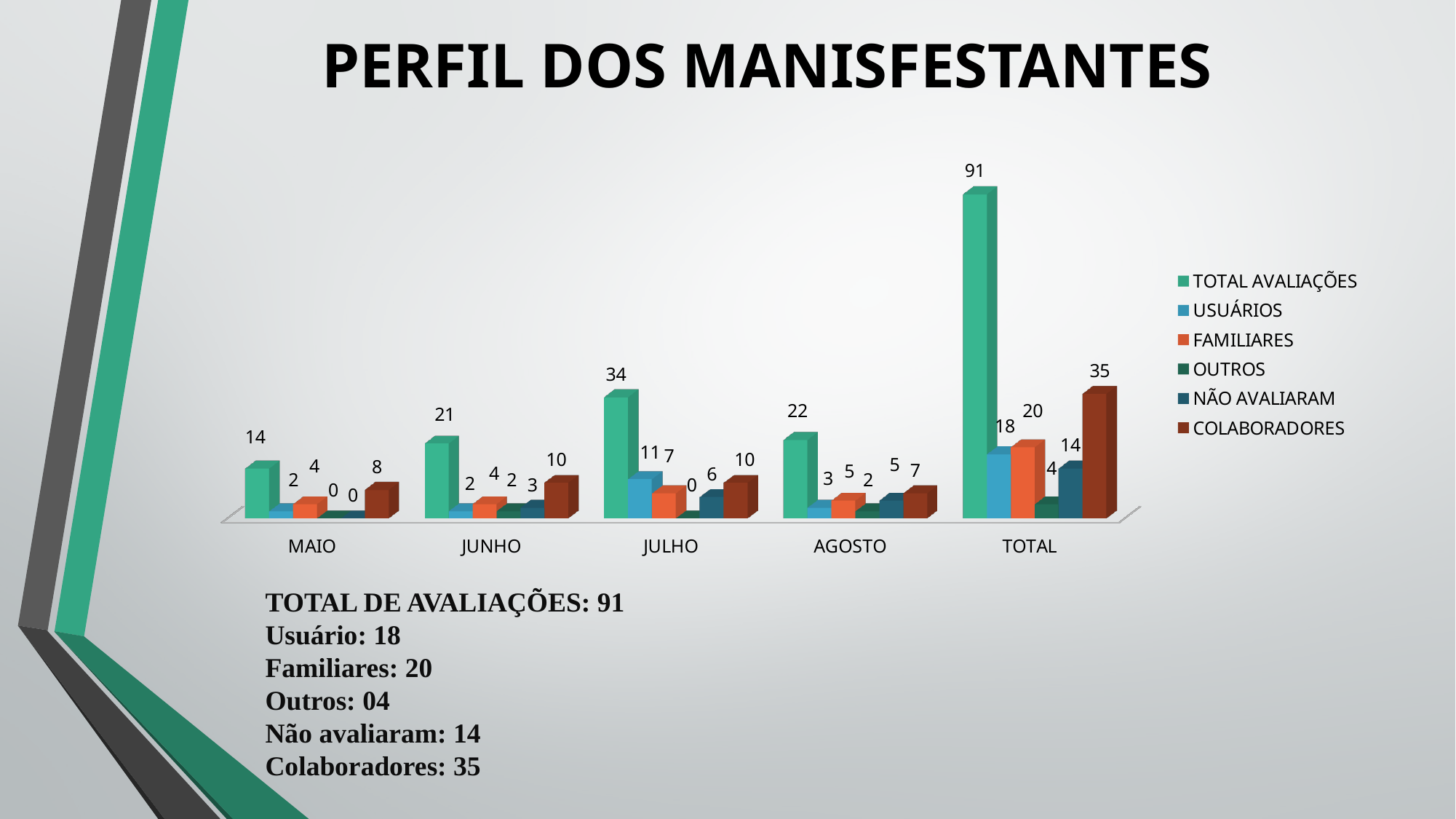
What is the value of NÃO AVALIARAM for MAIO? 0 What is the value of TOTAL AVALIAÇÕES for JULHO? 34 What is the value of COLABORADORES for TOTAL? 35 Among the months MAIO, JUNHO, JULHO and AGOSTO, which has the lowest TOTAL AVALIAÇÕES? MAIO What is the value of USUÁRIOS for JULHO? 11 What is the difference between TOTAL AVALIAÇÕES for JULHO and for JUNHO? 13 How many categories are shown on the x axis? 5 What kind of chart is shown on the slide? Bar chart What is the title of the slide containing the chart? PERFIL DOS MANISFESTANTES Which is larger for TOTAL: FAMILIARES or USUÁRIOS? FAMILIARES Among the months MAIO, JUNHO, JULHO and AGOSTO, which has the highest TOTAL AVALIAÇÕES? JULHO How many series does the legend list? 6